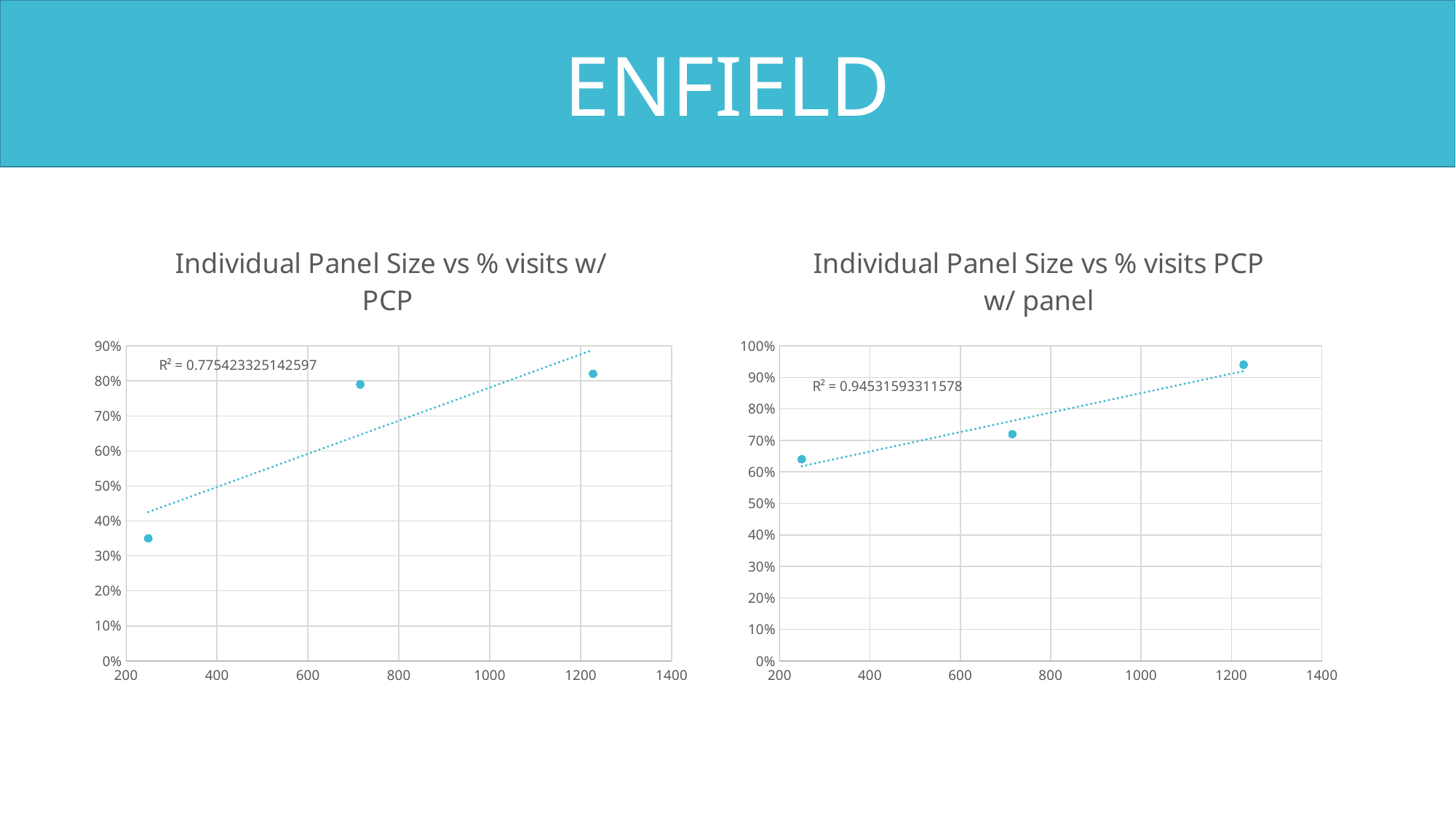
What R² value is shown on the left chart, 'Individual Panel Size vs % visits w/ PCP'? 0.775423325142597 In the left chart, 'Individual Panel Size vs % visits w/ PCP', is the value for the point with the largest panel size greater or less than 70%? greater In the left chart, 'Individual Panel Size vs % visits w/ PCP', do the % visits values rise or fall as panel size increases? rise What R² value is shown on the right chart, 'Individual Panel Size vs % visits PCP w/ panel'? 0.94531593311578 In the left chart, 'Individual Panel Size vs % visits w/ PCP', is the value for the point with the smallest panel size greater or less than 40%? less In the left chart, 'Individual Panel Size vs % visits w/ PCP', which point has a higher % visits value: the one with the smallest panel size or the one with the largest panel size? the one with the largest panel size In the right chart, 'Individual Panel Size vs % visits PCP w/ panel', do the % visits values rise or fall as panel size increases? rise How many data points are plotted in the right chart, 'Individual Panel Size vs % visits PCP w/ panel'? 3 In the right chart, 'Individual Panel Size vs % visits PCP w/ panel', is the value for the point with the largest panel size greater or less than 90%? greater What kind of chart is the left chart, 'Individual Panel Size vs % visits w/ PCP'? scatter chart How many data points are plotted in the left chart, 'Individual Panel Size vs % visits w/ PCP'? 3